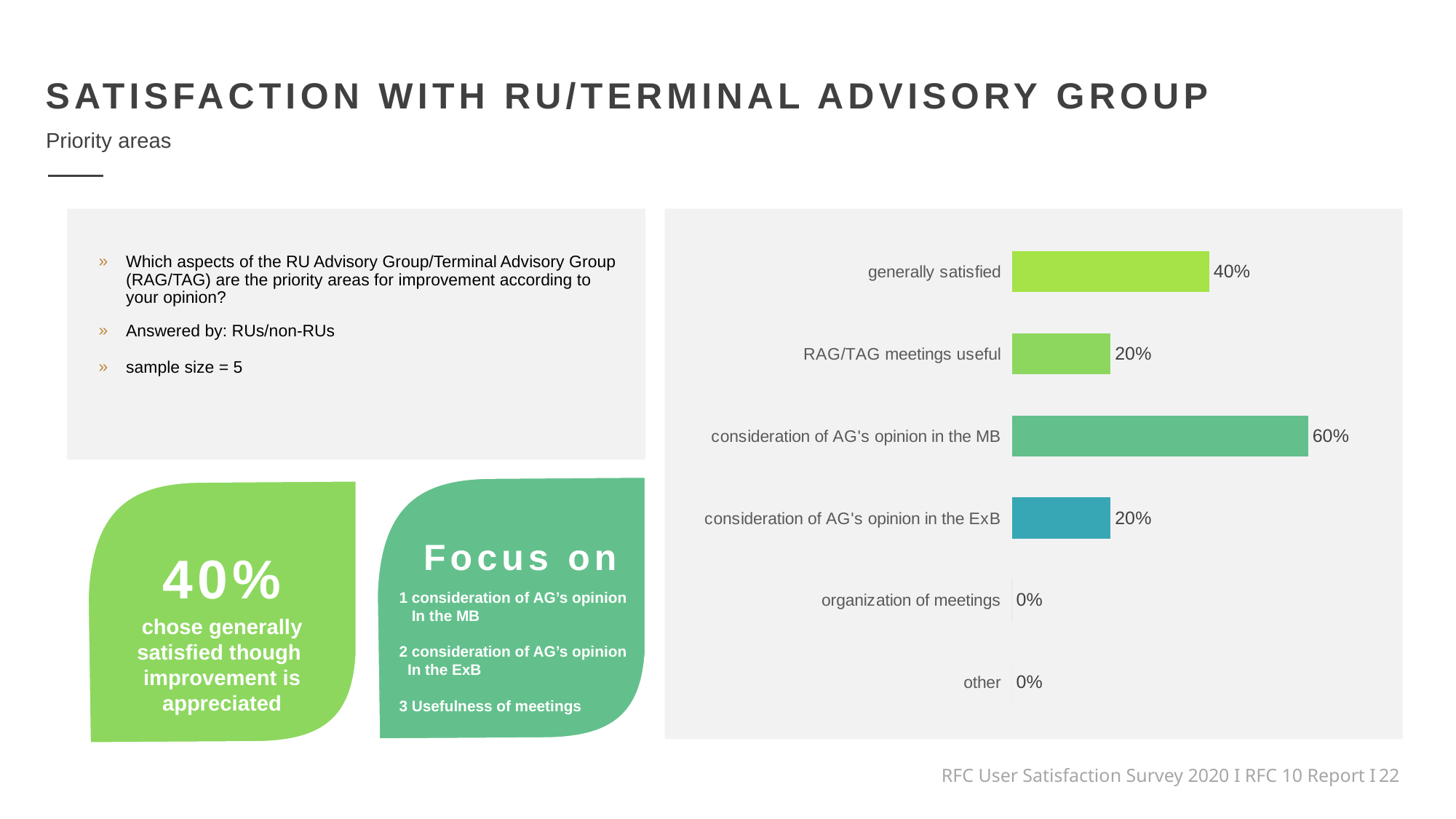
What percentage is shown for "consideration of AG's opinion in the MB"? 60% Which is larger: the value for "generally satisfied" or the value for "consideration of AG's opinion in the ExB"? generally satisfied How many categories are shown in the chart? 6 Which category has the highest value in the chart? consideration of AG's opinion in the MB What percentage is shown for "RAG/TAG meetings useful"? 20% What is the difference between the values for "consideration of AG's opinion in the MB" and "generally satisfied"? 20% What is the difference between the values for "generally satisfied" and "RAG/TAG meetings useful"? 20% How many categories in the chart have a value of 0%? 2 What colour is the bar for "consideration of AG's opinion in the ExB"? teal blue What kind of chart is shown on the slide? bar chart What percentage is shown for "generally satisfied"? 40% What percentage is shown for "organization of meetings"? 0%